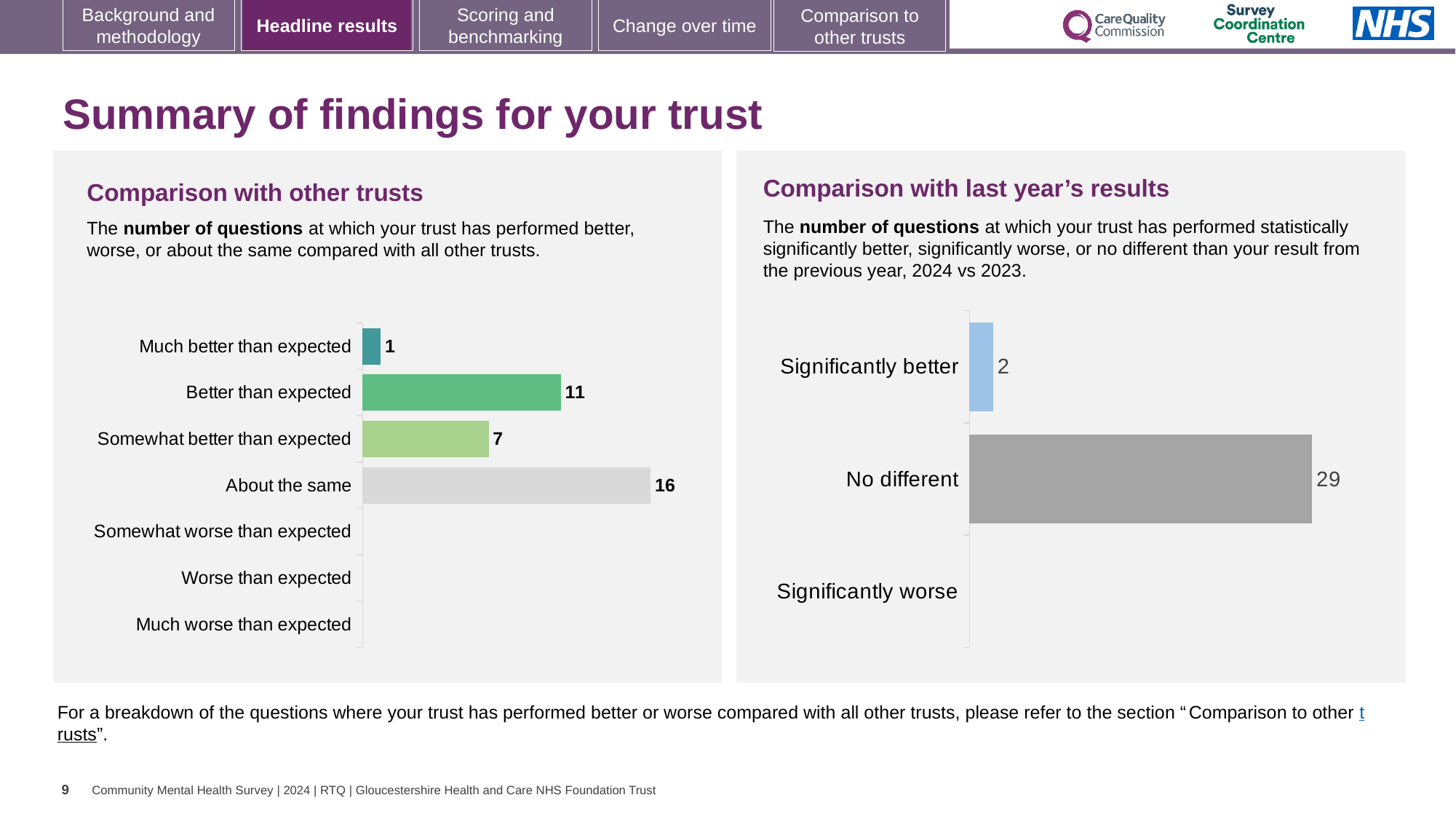
In the 'Comparison with other trusts' chart, what is the value for 'About the same'? 16 In the 'Comparison with other trusts' chart, how many questions are 'Better than expected'? 11 In the 'Comparison with other trusts' chart, what is the difference between 'About the same' and 'Better than expected'? 5 In the 'Comparison with last year's results' chart, what is the difference between 'No different' and 'Significantly better'? 27 In the 'Comparison with other trusts' chart, which is larger: 'Better than expected' or 'Somewhat better than expected'? Better than expected In the 'Comparison with last year's results' chart, what is the value for 'No different'? 29 What kind of chart is the 'Comparison with last year's results' chart? Bar chart In the 'Comparison with other trusts' chart, which category has the highest value? About the same How many categories are listed on the y axis of the 'Comparison with other trusts' chart? 7 In the 'Comparison with other trusts' chart, what is the value for 'Much better than expected'? 1 In the 'Comparison with last year's results' chart, what is the value for 'Significantly better'? 2 In the 'Comparison with last year's results' chart, what colour is the 'No different' bar? Grey